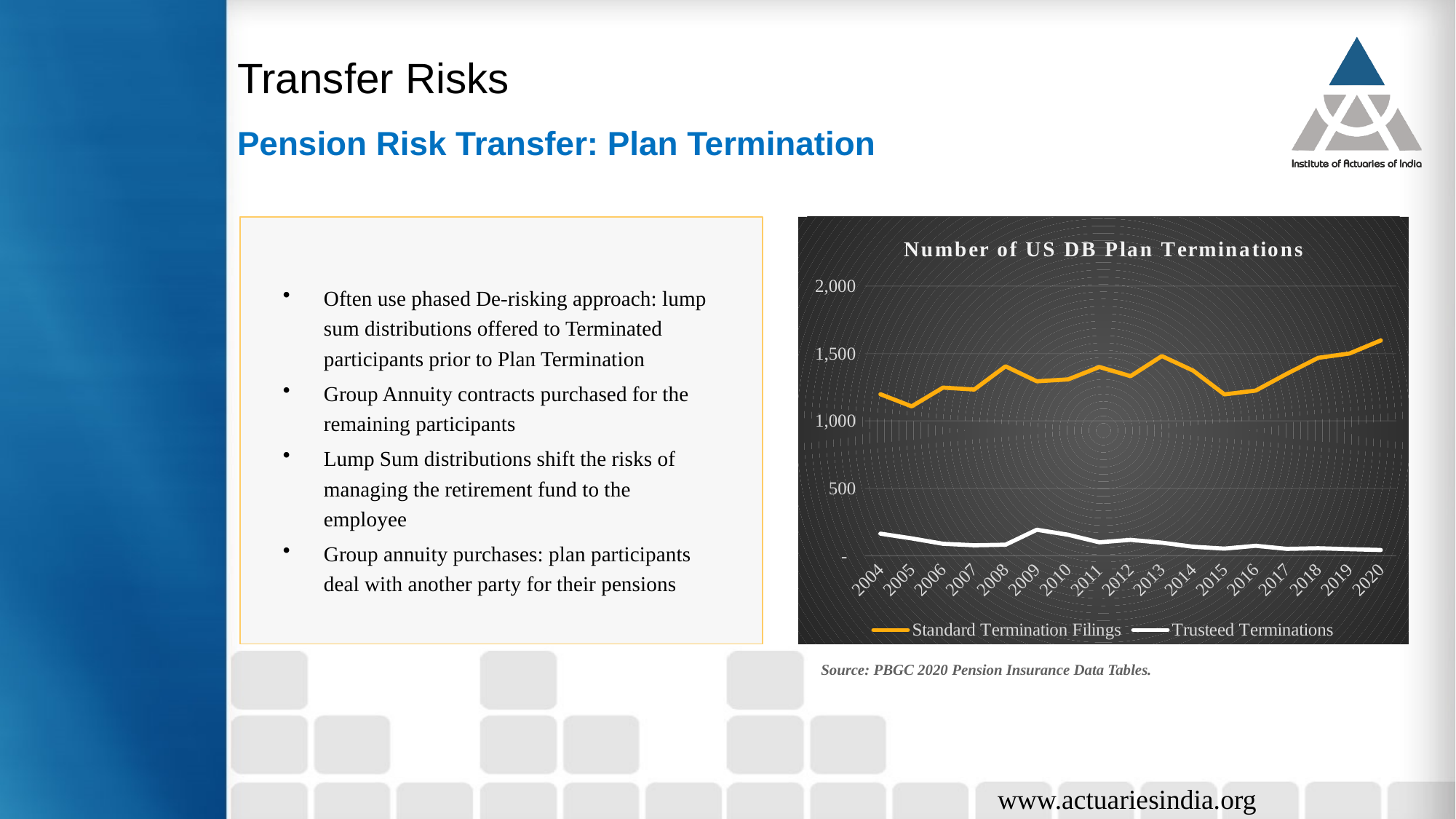
In which year are Trusteed Terminations highest? 2009 Is the value for Standard Termination Filings in 2005 greater or less than 1,500? less Do Standard Termination Filings rise or fall from 2015 to 2020? Rise How many years are shown on the x axis of the chart? 17 Which series is drawn in orange? Standard Termination Filings How many series does the chart legend list? 2 In 2010, which is larger: Standard Termination Filings or Trusteed Terminations? Standard Termination Filings Is the value for Trusteed Terminations in 2009 greater or less than 500? less Is the value for Standard Termination Filings in 2020 greater or less than 1,500? greater What type of chart is shown on the slide? Line chart In which year are Standard Termination Filings highest? 2020 What is the title of the chart? Number of US DB Plan Terminations